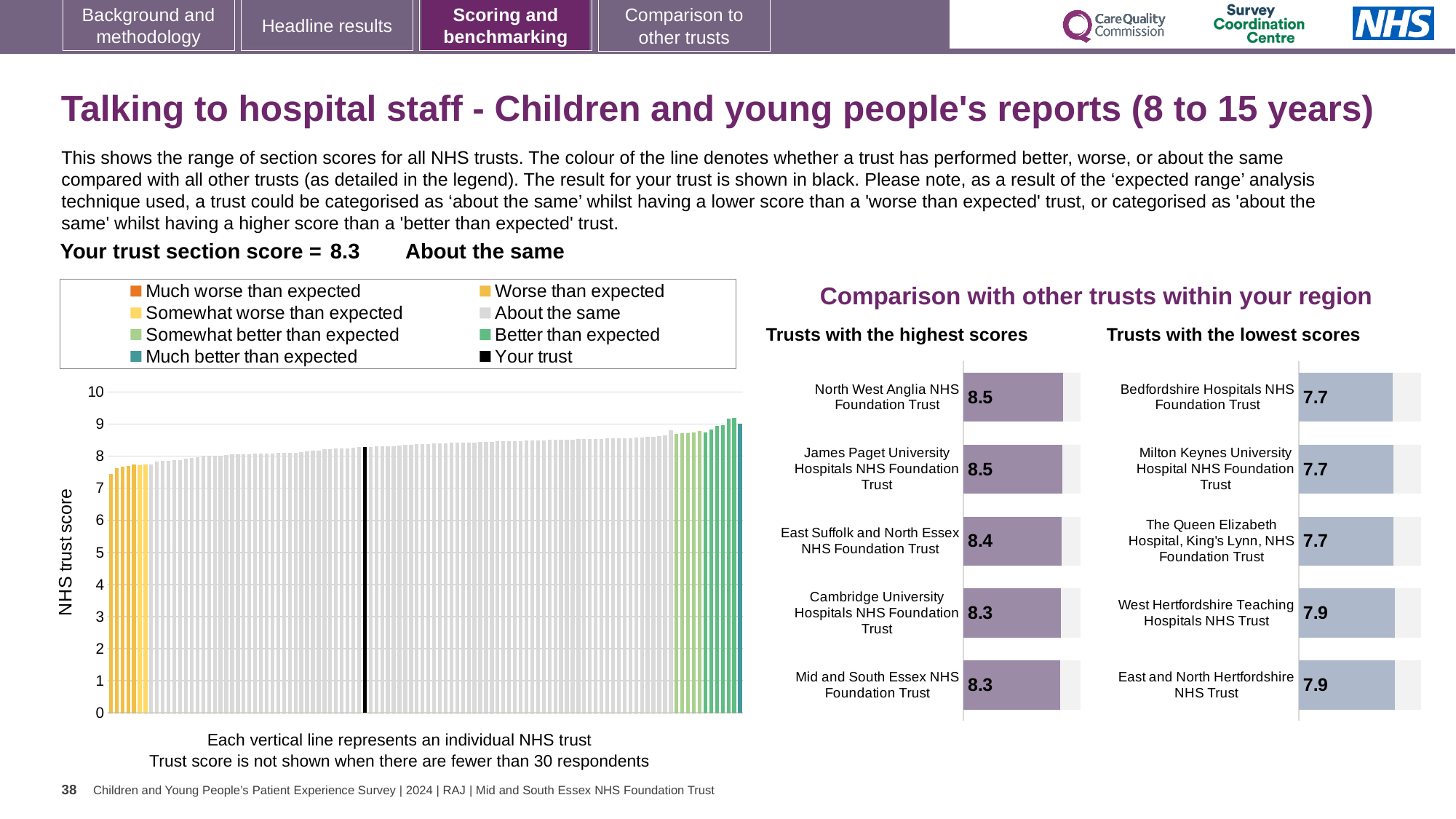
How many entries does the legend above the large chart on the left list? 8 How many trusts are listed in the 'Trusts with the lowest scores' chart? 5 In the large chart on the left, is the value for the black 'Your trust' bar greater or less than 8? greater In the 'Trusts with the highest scores' chart, what is the difference between the scores of North West Anglia NHS Foundation Trust and Cambridge University Hospitals NHS Foundation Trust? 0.2 How many trusts are listed in the 'Trusts with the highest scores' chart? 5 In the 'Trusts with the lowest scores' chart, what is the score for Bedfordshire Hospitals NHS Foundation Trust? 7.7 What kind of chart is the large chart on the left showing NHS trust scores? Bar chart In the 'Trusts with the lowest scores' chart, what is the score for West Hertfordshire Teaching Hospitals NHS Trust? 7.9 In the 'Trusts with the lowest scores' chart, which has the higher score: West Hertfordshire Teaching Hospitals NHS Trust or Milton Keynes University Hospital NHS Foundation Trust? West Hertfordshire Teaching Hospitals NHS Trust In the large chart on the left, do the trust scores rise or fall from left to right along the x axis? Rise In the 'Trusts with the highest scores' chart, what is the score for East Suffolk and North Essex NHS Foundation Trust? 8.4 In the 'Trusts with the highest scores' chart, what is the score for North West Anglia NHS Foundation Trust? 8.5